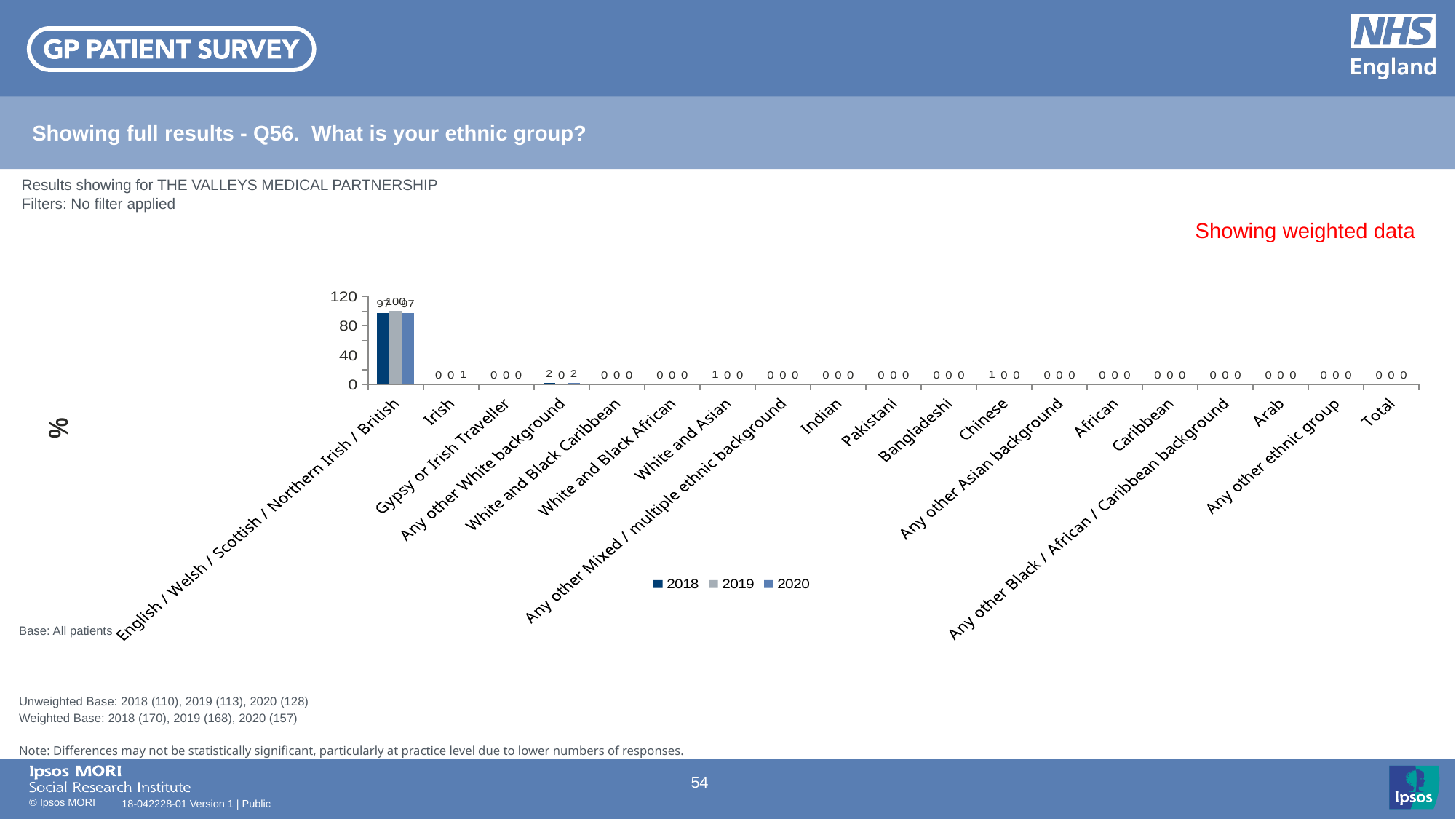
What is the 2018 value for Any other White background? 2 Which years are listed in the chart legend? 2018, 2019, 2020 How many series does the chart legend list? 3 What is the 2018 value for White and Asian? 1 Which category has the highest value for 2019? English / Welsh / Scottish / Northern Irish / British What is the 2020 value for Irish? 1 Which is larger for 2020: the value for Irish or the value for Gypsy or Irish Traveller? Irish What is the difference between the 2018 and 2019 values for Any other White background? 2 What kind of chart is shown on the slide? Bar chart Is the 2018 value for English / Welsh / Scottish / Northern Irish / British greater or less than 80? greater What is the 2020 value for Any other White background? 2 What is the 2018 value for Chinese? 1